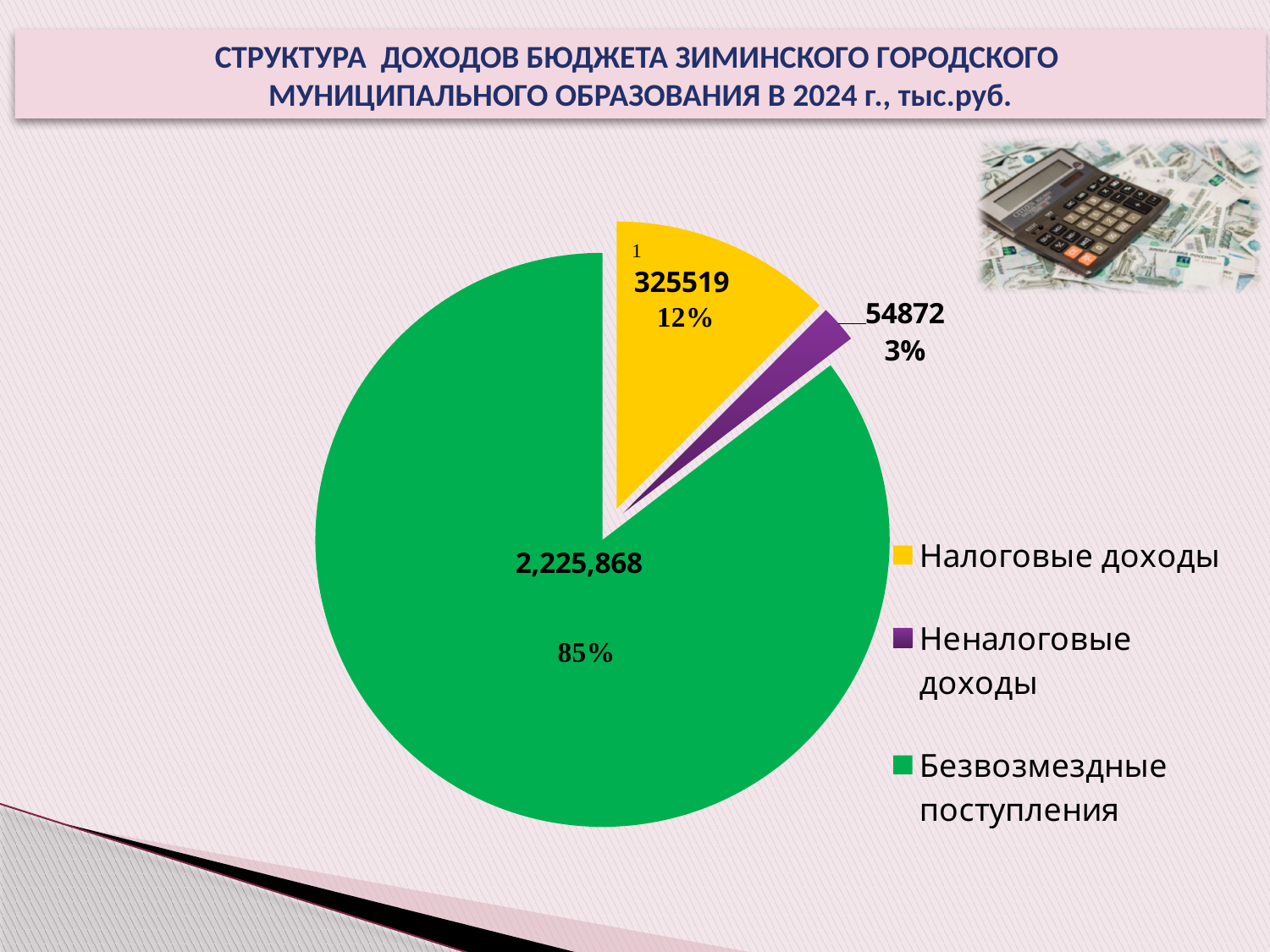
What is the difference between the values for Налоговые доходы and Неналоговые доходы? 270647 How many categories does the legend list? 3 Which category has the largest slice of the pie? Безвозмездные поступления What share of the pie does Безвозмездные поступления represent? 85% Which is larger, Налоговые доходы or Неналоговые доходы? Налоговые доходы Which category has the smallest slice of the pie? Неналоговые доходы What share of the pie does Налоговые доходы represent? 12% What is the value for Налоговые доходы? 325519 What share of the pie does Неналоговые доходы represent? 3% What is the value for Неналоговые доходы? 54872 What is the value for Безвозмездные поступления? 2,225,868 What kind of chart is shown on the slide? pie chart